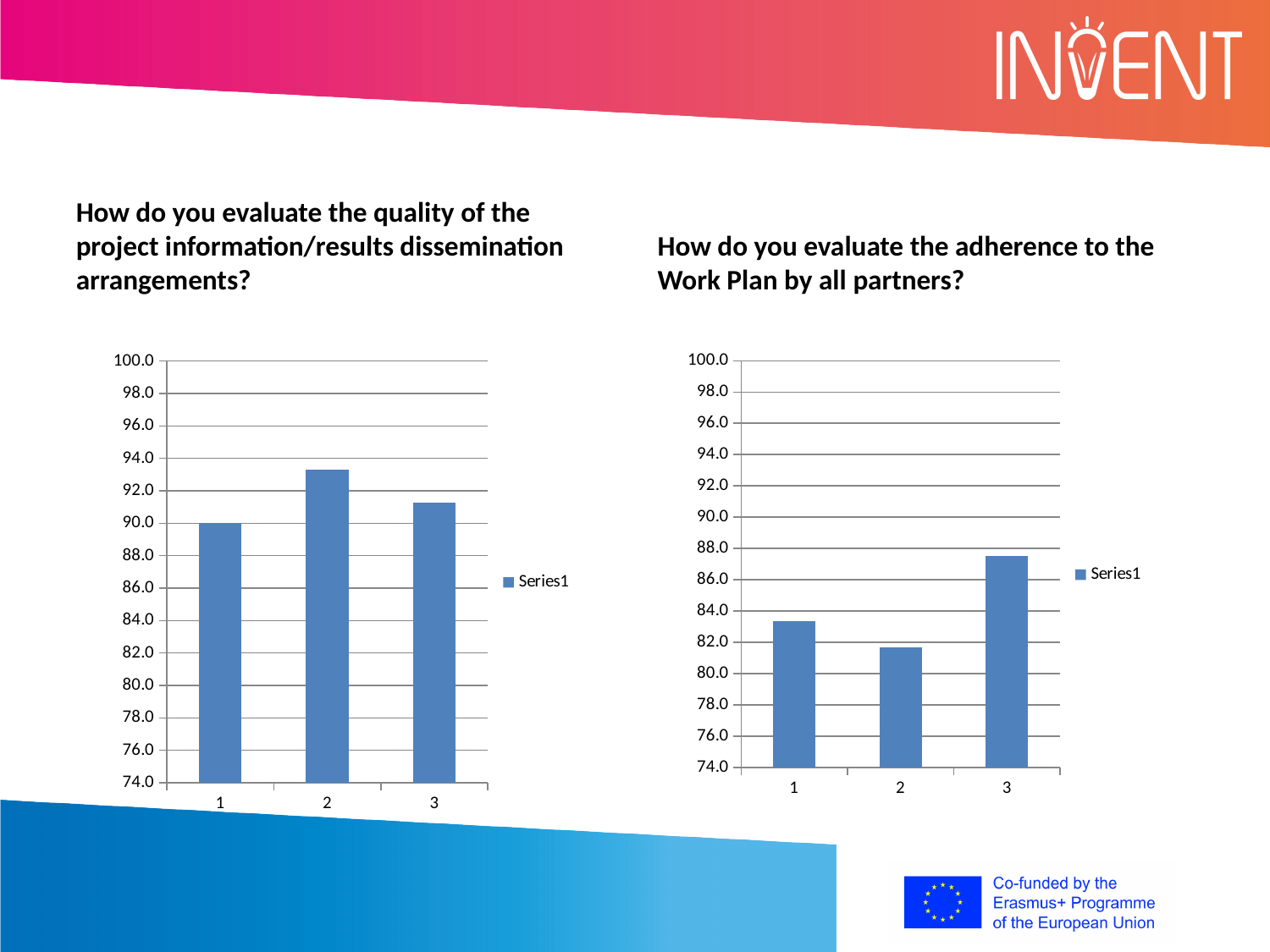
In the left chart (quality of dissemination arrangements), is the value for category 2 greater or less than 92.0? greater In the left chart (quality of dissemination arrangements), which category has the lowest value? 1 How many series does the legend of the left chart list? 1 In the left chart (quality of dissemination arrangements), which category has the highest value? 2 In the right chart (adherence to the Work Plan), which is larger, the value for category 1 or category 2? category 1 In the right chart (adherence to the Work Plan), is the value for category 1 greater or less than 84.0? less What type of chart is the left chart, titled 'How do you evaluate the quality of the project information/results dissemination arrangements?'? bar chart In the right chart (adherence to the Work Plan), is the value for category 3 greater or less than 86.0? greater In the right chart (adherence to the Work Plan), which category has the lowest value? 2 In the right chart (adherence to the Work Plan), which category has the highest value? 3 How many categories are shown on the x axis of the right chart, titled 'How do you evaluate the adherence to the Work Plan by all partners?'? 3 What is the name of the series shown in the legend of the right chart? Series1